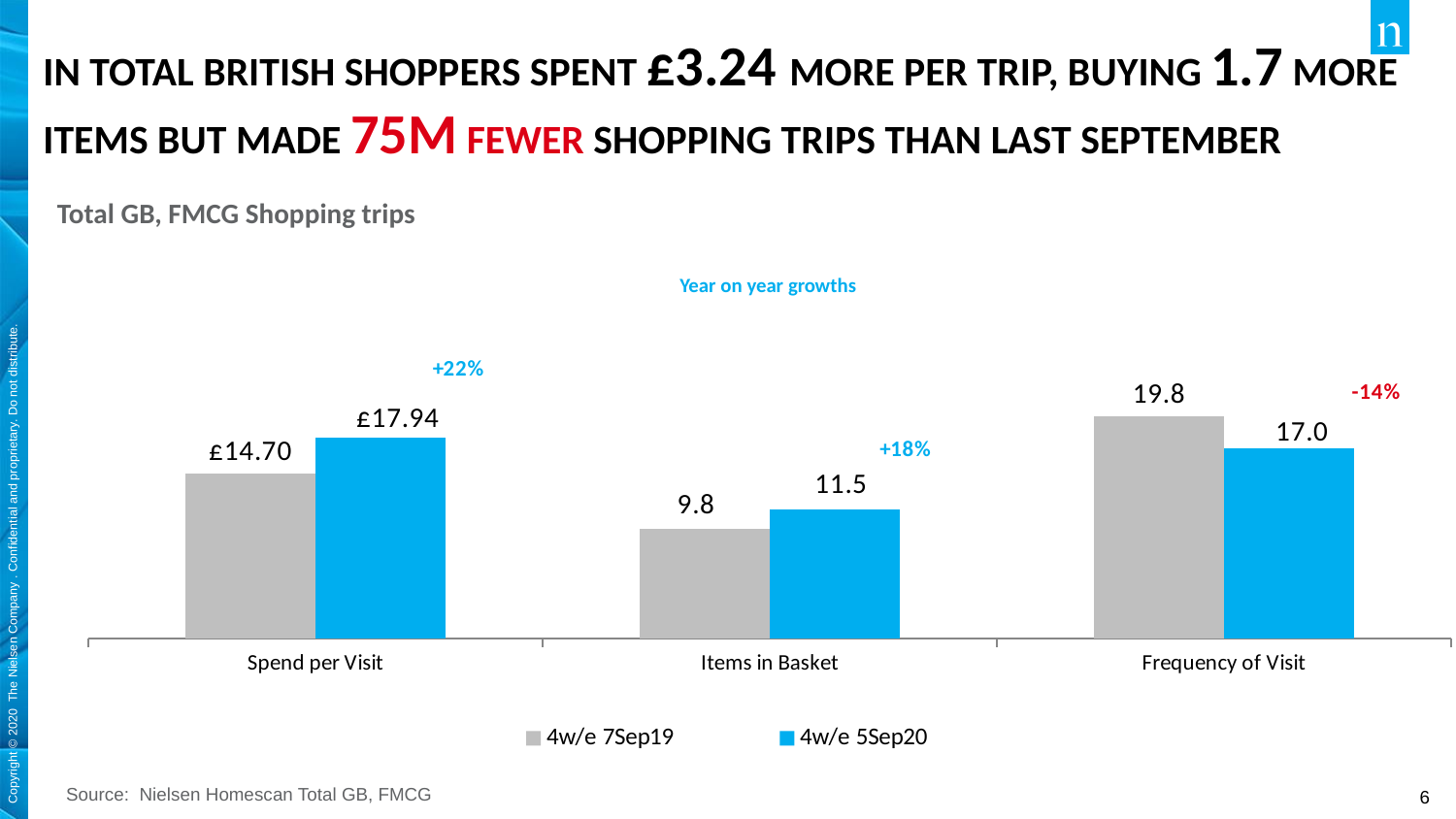
For Frequency of Visit, which series has the larger value, 4w/e 7Sep19 or 4w/e 5Sep20? 4w/e 7Sep19 What kind of chart is shown on the slide? Bar chart What is the year on year growth shown for Spend per Visit? +22% For Spend per Visit, which series has the larger value, 4w/e 7Sep19 or 4w/e 5Sep20? 4w/e 5Sep20 What is the year on year growth shown for Frequency of Visit? -14% How many series does the legend list? 2 How many categories are shown on the x axis of the chart? 3 What is the Items in Basket value for 4w/e 7Sep19? 9.8 What is the difference between the Items in Basket values for 4w/e 5Sep20 and 4w/e 7Sep19? 1.7 What is the Frequency of Visit value for 4w/e 5Sep20? 17.0 What is the Spend per Visit value for 4w/e 5Sep20? £17.94 What is the difference between the Frequency of Visit values for 4w/e 7Sep19 and 4w/e 5Sep20? 2.8